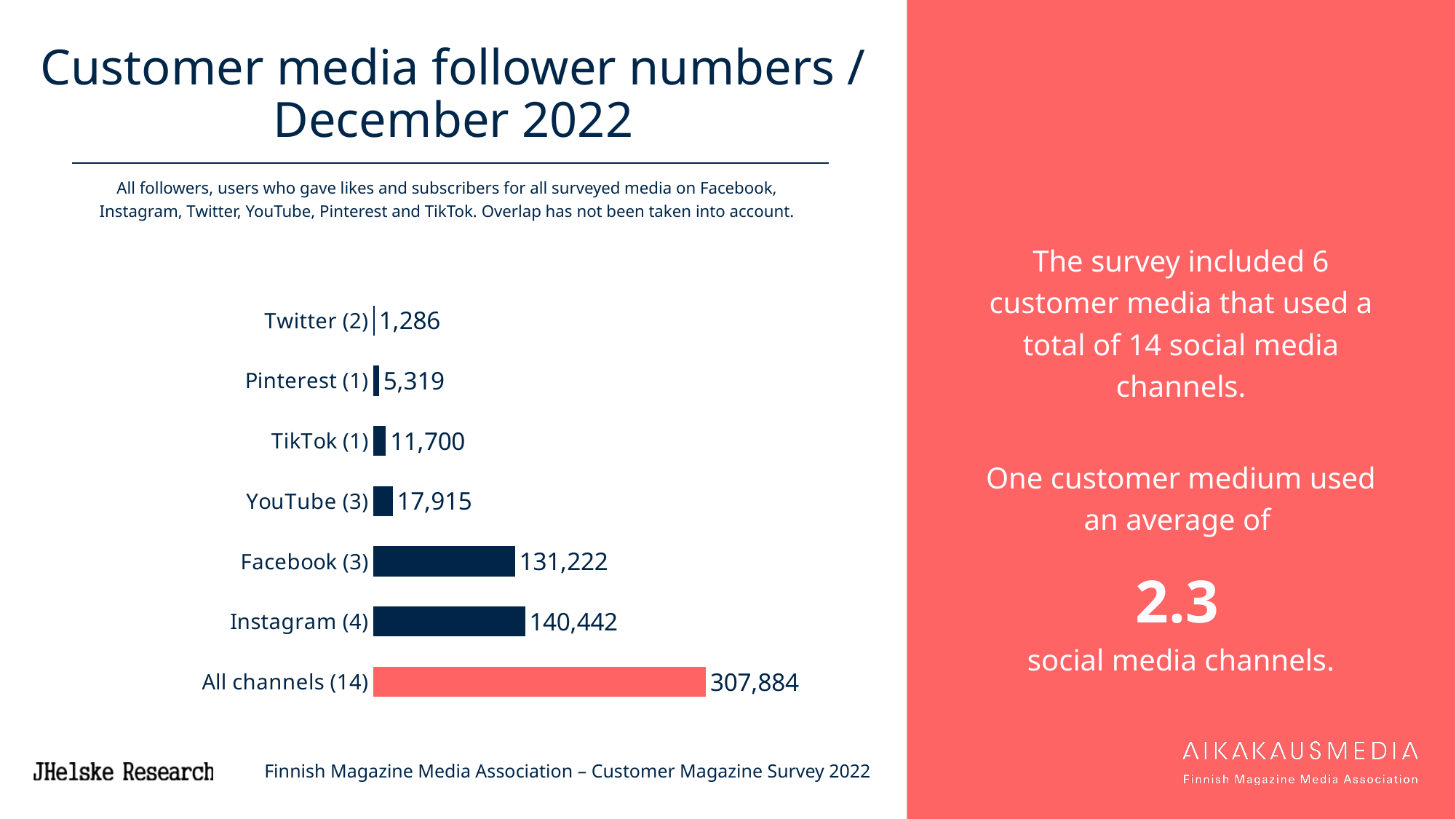
Which individual channel (excluding All channels) has the highest follower number? Instagram (4) What is the follower number for Facebook (3)? 131,222 What is the difference between the follower numbers for Instagram (4) and Facebook (3)? 9,220 How many bars are shown in the chart? 7 What kind of chart is shown on the slide? Bar chart Which channel has the lowest follower number? Twitter (2) What is the follower number for YouTube (3)? 17,915 Which has more followers, TikTok (1) or Pinterest (1)? TikTok (1) What is the follower number for Instagram (4)? 140,442 What is the title of the slide containing the chart? Customer media follower numbers / December 2022 What is the follower number for Twitter (2)? 1,286 What is the follower number for All channels (14)? 307,884